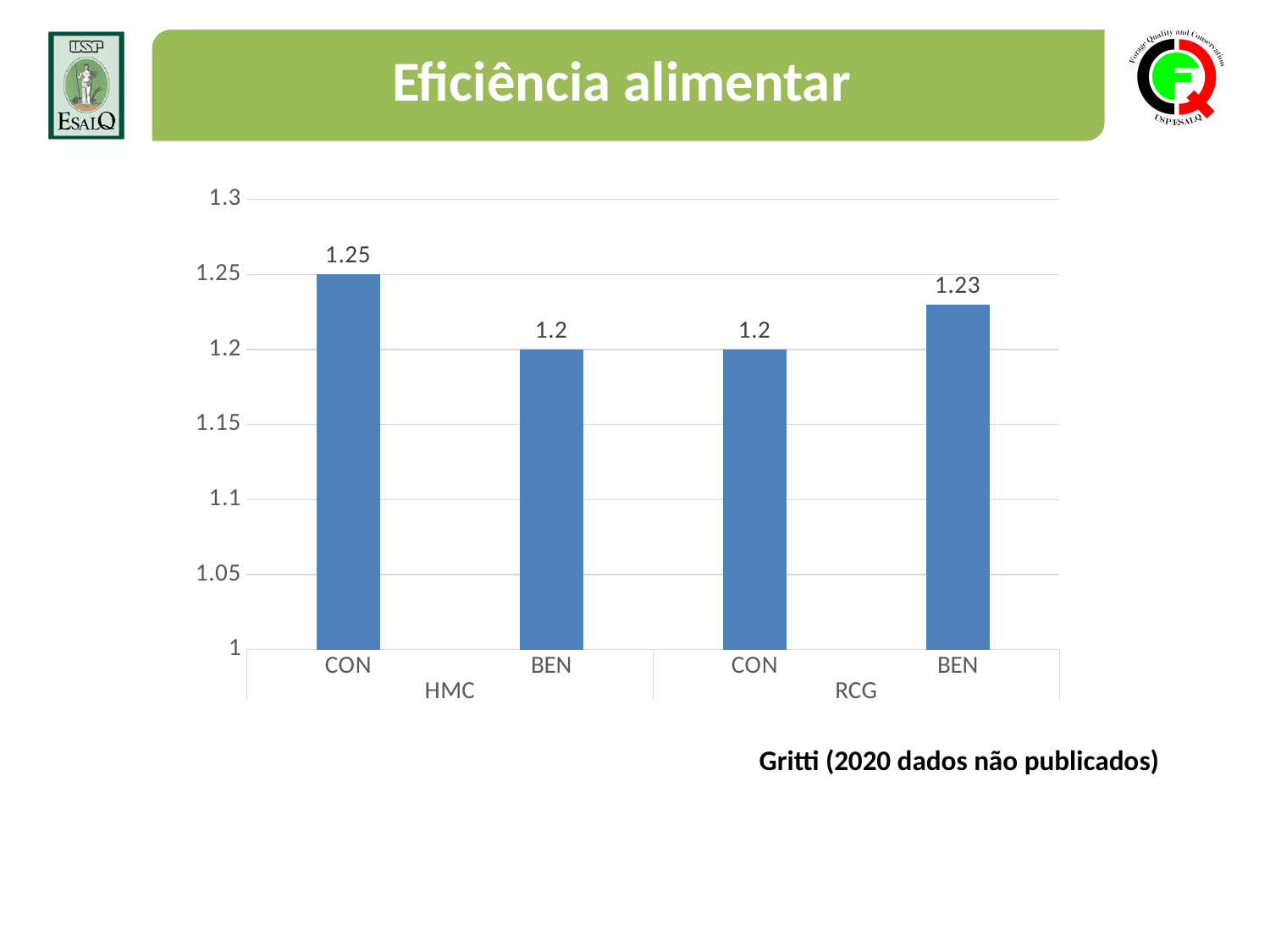
Which is larger, CON in HMC or BEN in RCG? CON in HMC Which bar has the highest value? CON (HMC) How many bars are plotted in the chart? 4 What is the difference between CON and BEN in the HMC group? 0.05 What is the value for BEN in the RCG group? 1.23 What are the two group labels on the x axis? HMC and RCG What kind of chart is shown on the slide? bar chart What is the value for BEN in the HMC group? 1.2 What is the title of the slide? Eficiência alimentar What is the value for CON in the HMC group? 1.25 Is the value for BEN in the RCG group greater or less than 1.25? less What is the difference between BEN and CON in the RCG group? 0.03